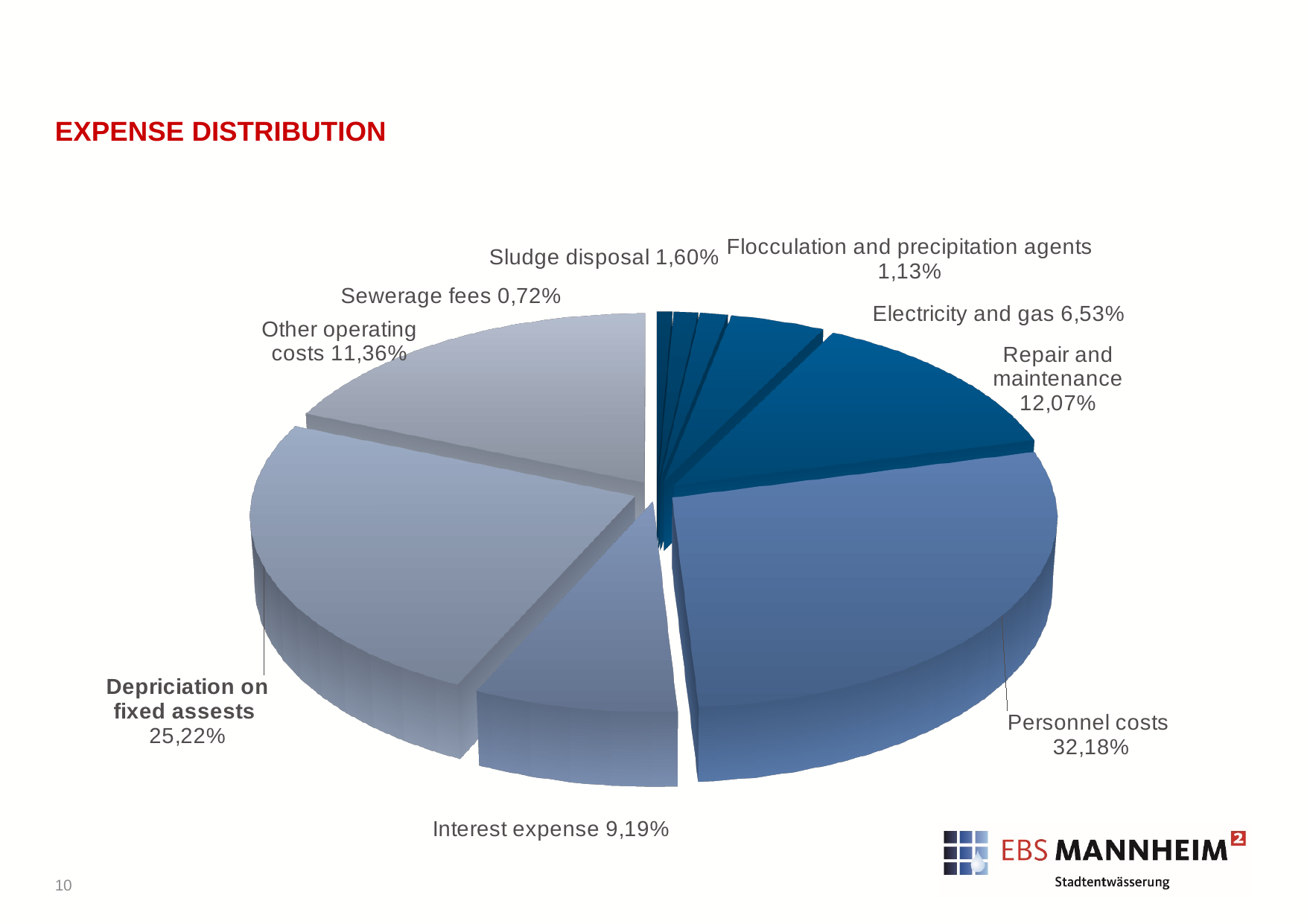
What kind of chart is shown on the slide? Pie chart Which is larger, Other operating costs or Electricity and gas? Other operating costs What share of expenses is Personnel costs? 32,18% What is the value for Sewerage fees? 0,72% What is the title of the slide? EXPENSE DISTRIBUTION How many categories are shown in the pie chart? 9 What percentage is shown for Repair and maintenance? 12,07% What share is labelled for Interest expense? 9,19% What is the difference between the Sludge disposal share and the Flocculation and precipitation agents share? 0,47% Which category has the largest share of the pie? Personnel costs What is the difference between the Personnel costs share and the Depriciation on fixed assests share? 6,96% Which category has the smallest share of the pie? Sewerage fees